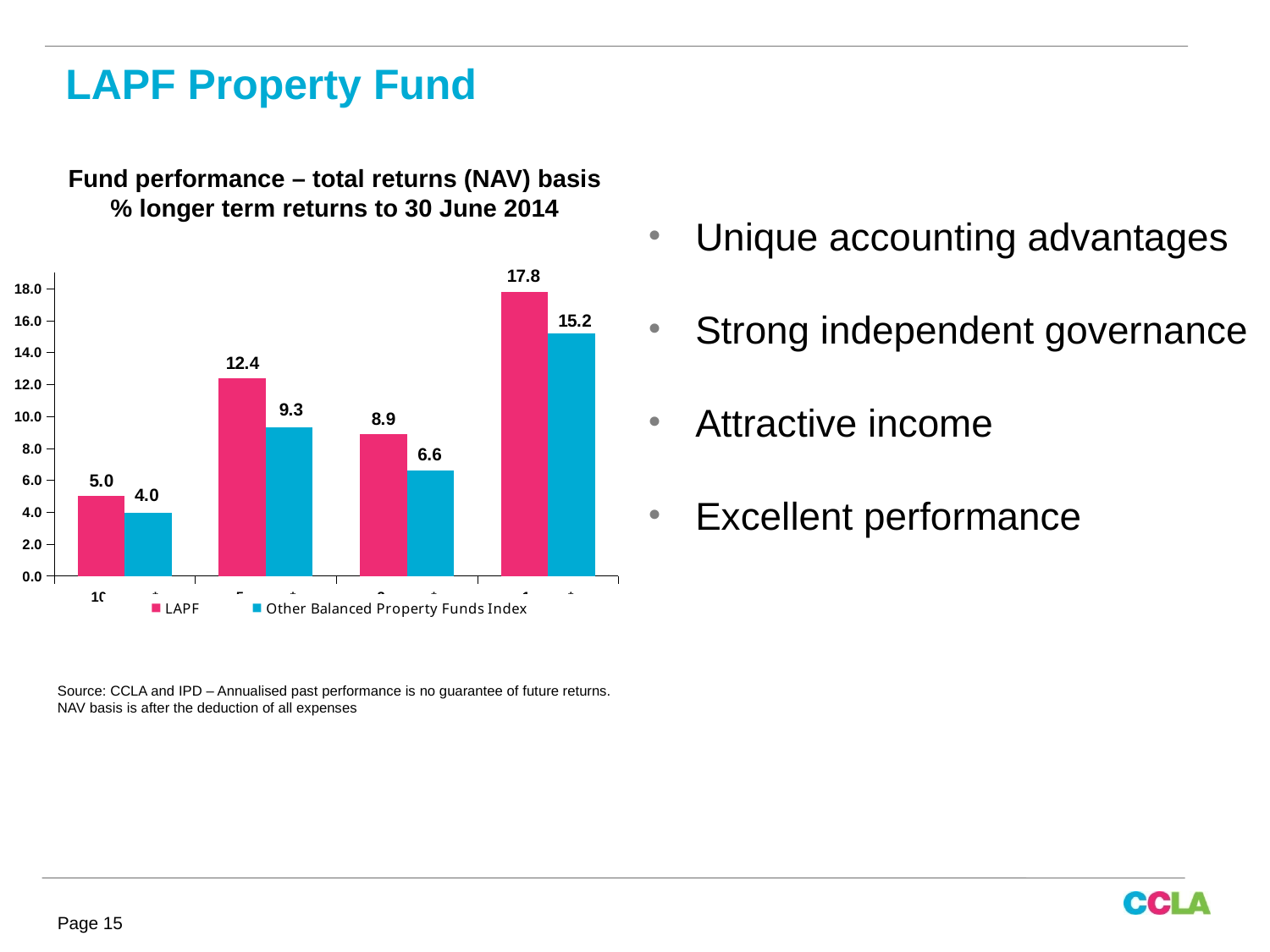
How many groups of bars are plotted in the chart? 4 In the rightmost group of bars, which series has the larger value, LAPF or Other Balanced Property Funds Index? LAPF What is the highest LAPF value shown in the chart? 17.8 Which series is shown in pink in the chart? LAPF What is the Other Balanced Property Funds Index value for the third group of bars from the left? 6.6 What is the LAPF value for the rightmost group of bars? 17.8 What is the LAPF value for the leftmost group of bars? 5.0 What type of chart is shown on the slide? bar chart What is the Other Balanced Property Funds Index value for the leftmost group of bars? 4.0 In the second group of bars from the left, what is the difference between the LAPF value and the Other Balanced Property Funds Index value? 3.1 How many series does the chart legend list? 2 What is the lowest Other Balanced Property Funds Index value shown in the chart? 4.0